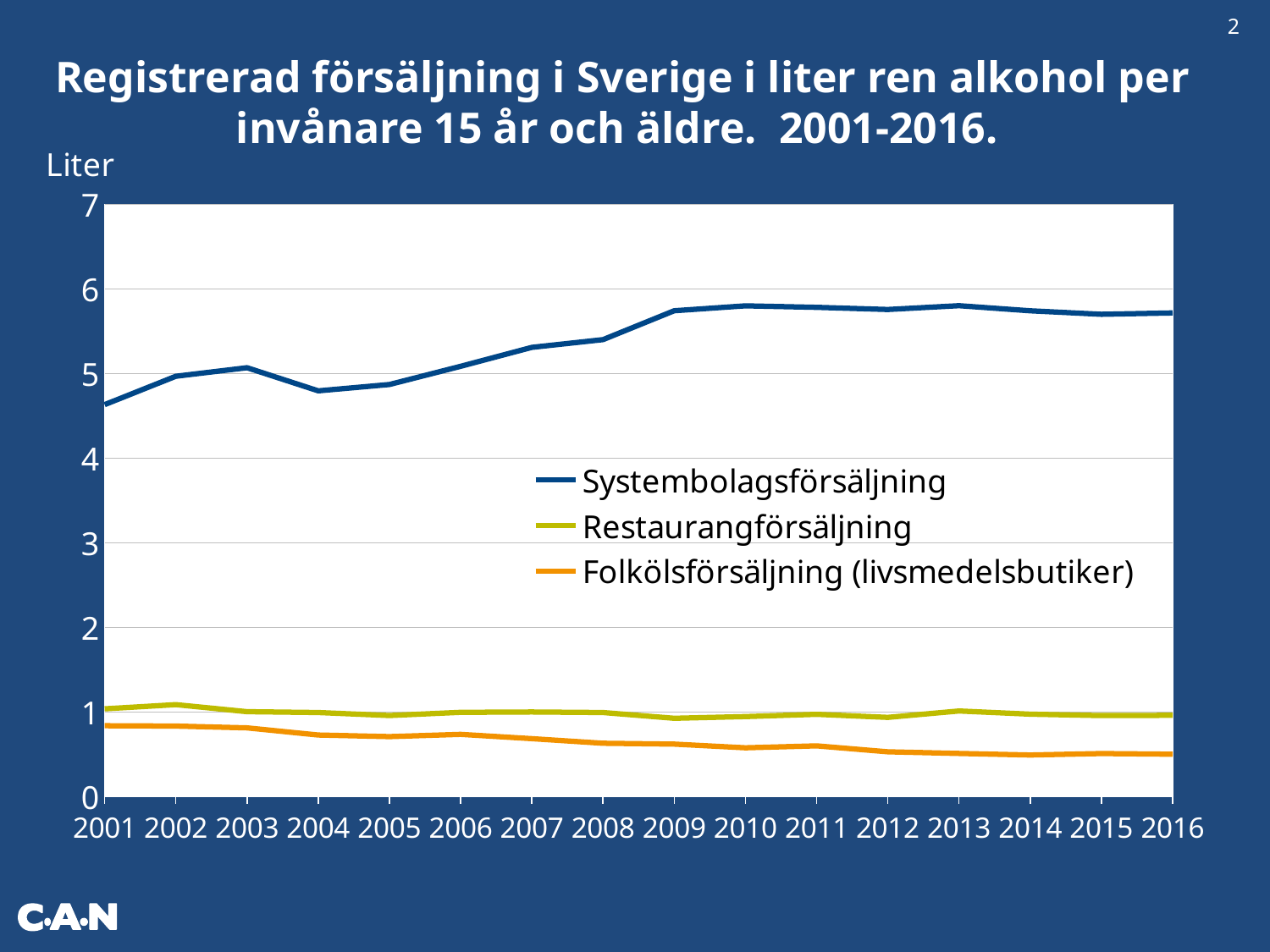
Is the value for Systembolagsförsäljning in 2001 greater or less than 5? less What kind of chart is shown on the slide? line chart In 2016, which is larger: Restaurangförsäljning or Folkölsförsäljning (livsmedelsbutiker)? Restaurangförsäljning Does Folkölsförsäljning (livsmedelsbutiker) rise or fall from 2001 to 2016? fall Is the value for Systembolagsförsäljning in 2016 greater or less than 6? less How many years are shown along the x axis? 16 Is the value for Systembolagsförsäljning in 2010 greater or less than 5? greater Which series has the lowest values throughout the chart? Folkölsförsäljning (livsmedelsbutiker) How many series does the legend list? 3 Which series has the highest values throughout the chart? Systembolagsförsäljning What unit is shown on the y axis label? Liter